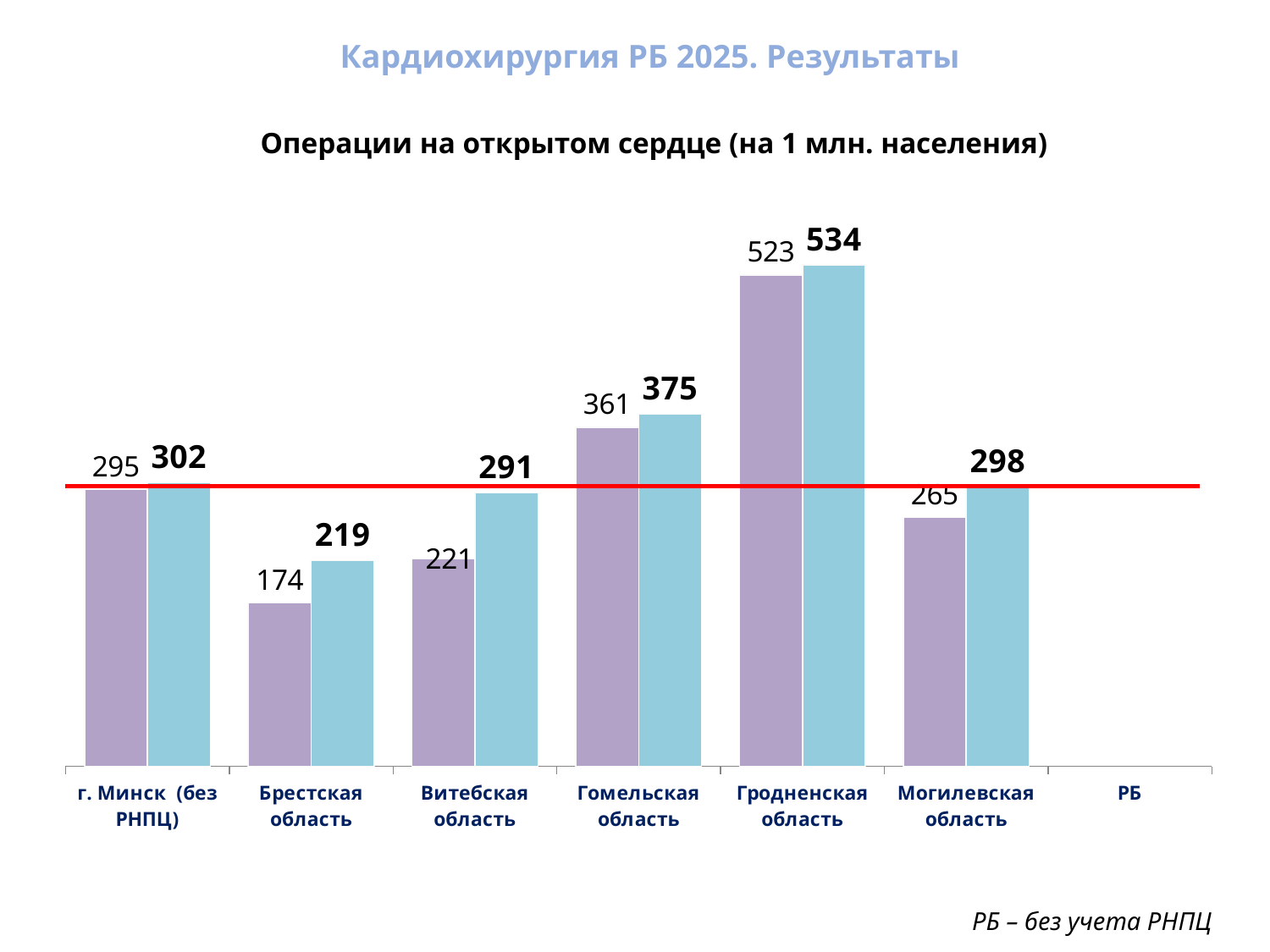
What is the difference between the blue and purple bar values for Брестская область? 45 How many categories on the x axis have bars plotted? 6 What is the difference between the blue and purple bar values for Гродненская область? 11 What is the value of the purple bar for Могилевская область? 265 Which region has the lowest value among the purple bars? Брестская область Which is larger: the blue bar for г. Минск (без РНПЦ) or the blue bar for Гомельская область? Гомельская область What is the title of the chart? Операции на открытом сердце (на 1 млн. населения) What is the value of the blue bar for Гродненская область? 534 What kind of chart is shown on the slide? Bar chart What is the value of the blue bar for Витебская область? 291 Which region has the highest value among the blue bars? Гродненская область What is the value of the purple bar for Брестская область? 174